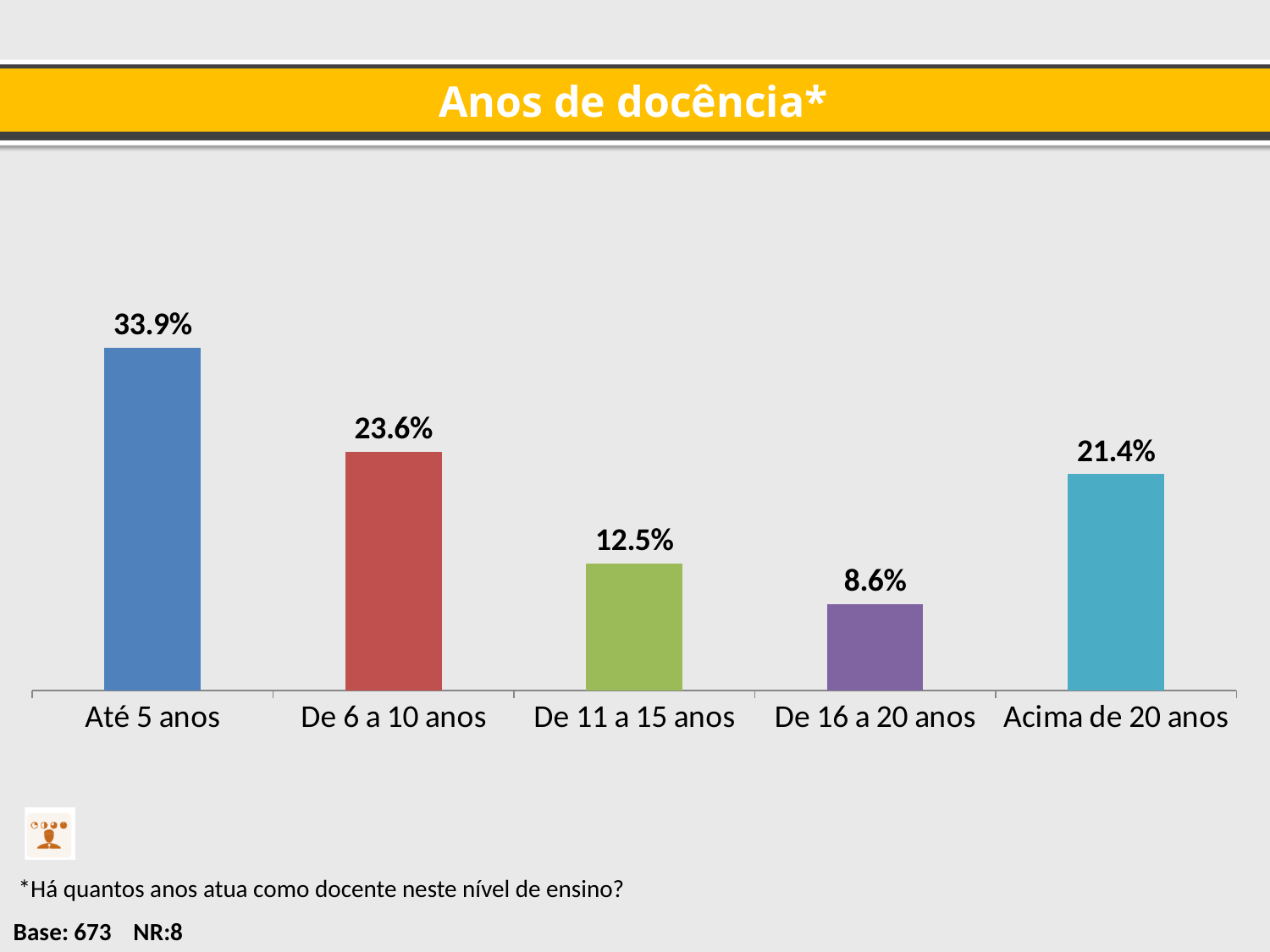
Which is larger, the value for 'De 6 a 10 anos' or 'Acima de 20 anos'? De 6 a 10 anos What is the value for 'De 6 a 10 anos'? 23.6% What is the value for 'Acima de 20 anos'? 21.4% Which category has the highest value? Até 5 anos How many categories are shown on the chart? 5 What kind of chart is shown on the slide? Bar chart What is the title of the chart? Anos de docência* Which category has the lowest value? De 16 a 20 anos What is the value for 'De 11 a 15 anos'? 12.5% What is the value for 'Até 5 anos'? 33.9% What is the value for 'De 16 a 20 anos'? 8.6% What is the difference between the values for 'Até 5 anos' and 'De 6 a 10 anos'? 10.3%